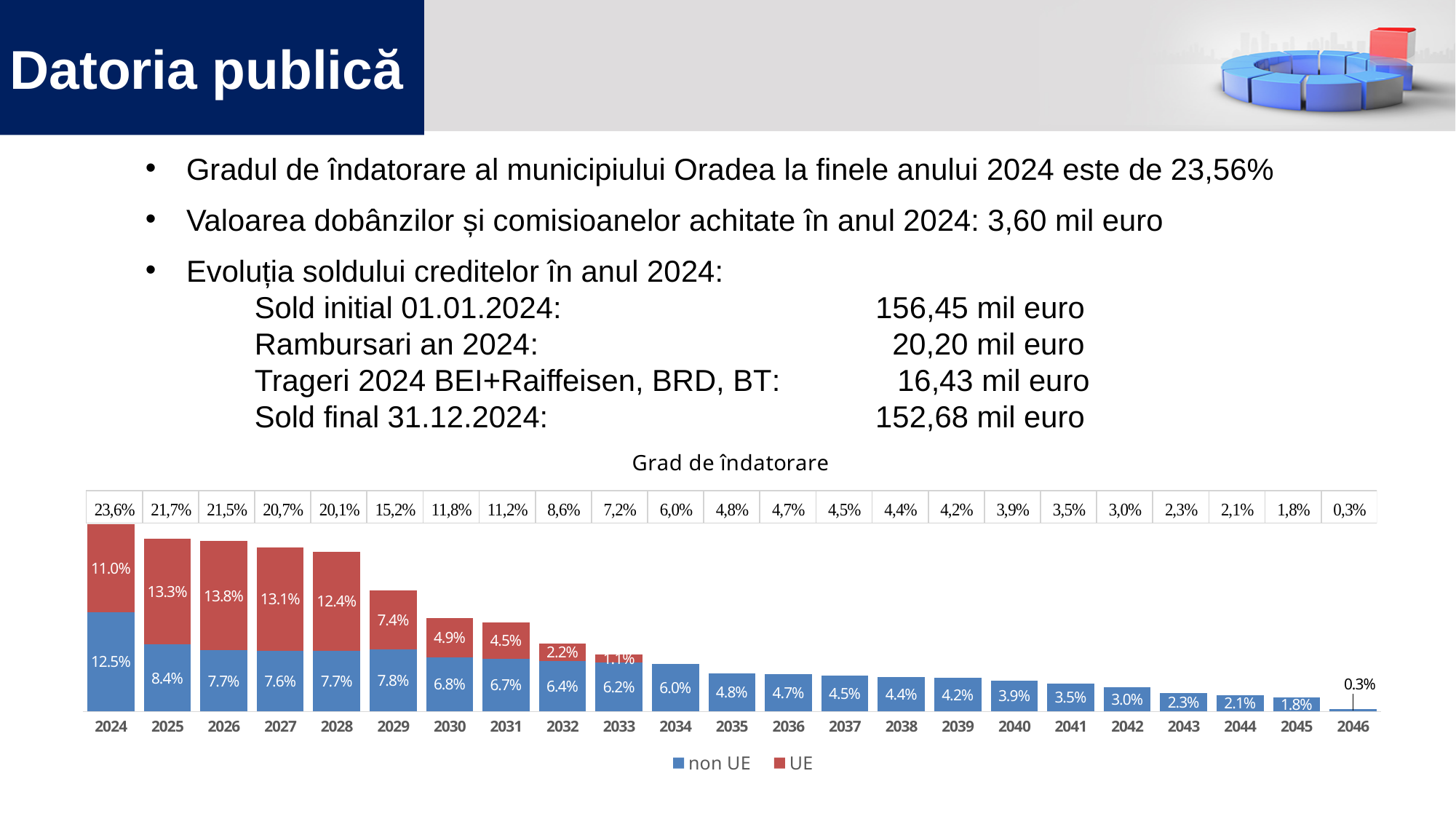
Which year has the lowest total Grad de îndatorare? 2046 How many series does the legend of the Grad de îndatorare chart list? 2 What is the total Grad de îndatorare shown for 2029? 15,2% What is the UE value for 2026 in the Grad de îndatorare chart? 13.8% What kind of chart is the Grad de îndatorare chart? Stacked bar chart What are the two legend entries in the Grad de îndatorare chart? non UE and UE In 2024, which is larger: the non UE value or the UE value? non UE What is the non UE value for 2024 in the Grad de îndatorare chart? 12.5% Which year has the highest total Grad de îndatorare? 2024 Do the total Grad de îndatorare values rise or fall from 2024 to 2046? Fall How many years are shown on the x axis of the Grad de îndatorare chart? 23 What is the difference between the UE value for 2025 and the UE value for 2024? 2.3%